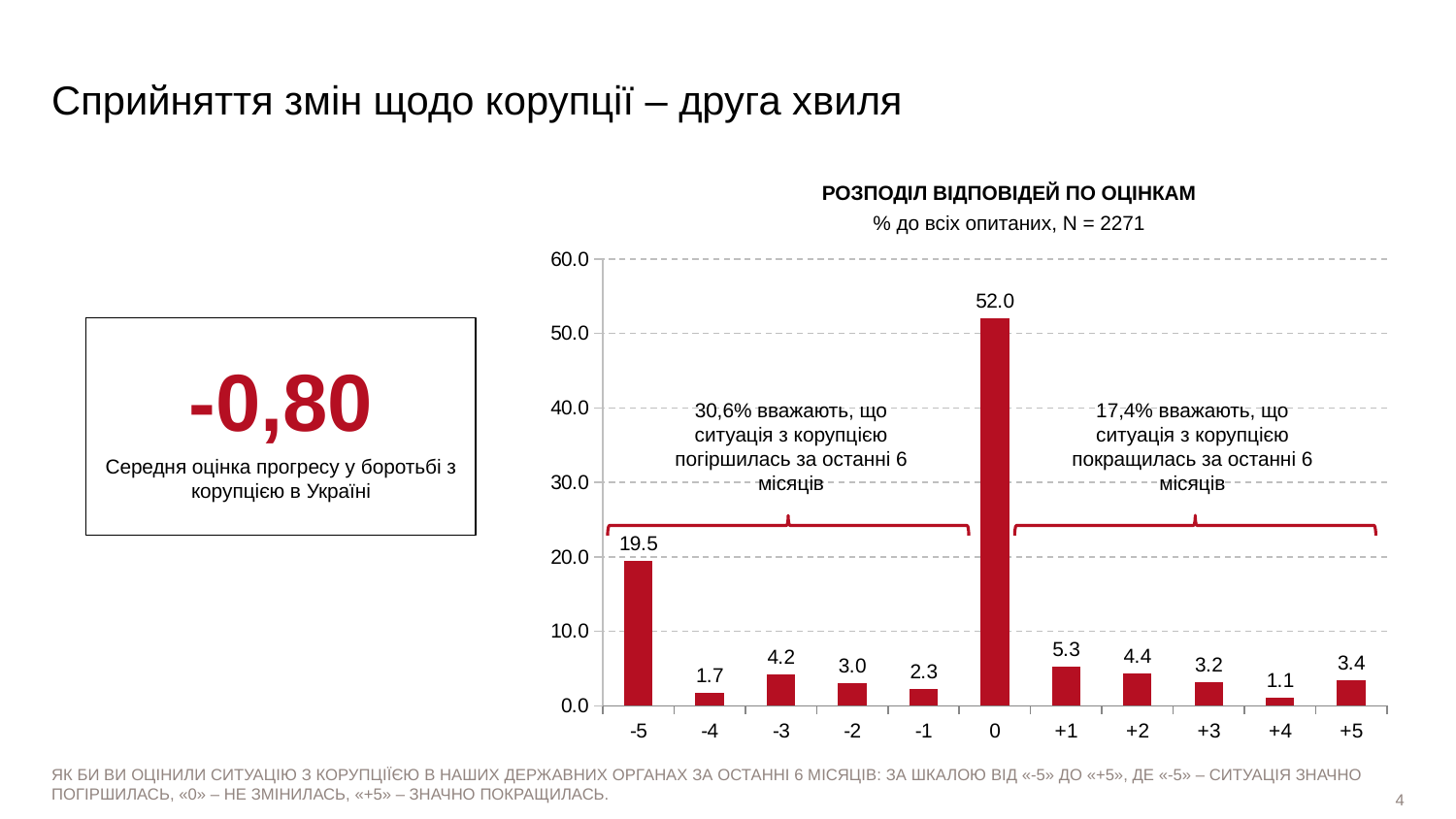
Is the value for "-5" greater or less than 10.0? greater What is the sample size N stated in the chart subtitle? 2271 What is the value for the "0" category? 52.0 Which category has the highest value? 0 How many categories are shown on the x axis? 11 Which is larger, the value for "+1" or the value for "-3"? +1 What is the title of the chart? РОЗПОДІЛ ВІДПОВІДЕЙ ПО ОЦІНКАМ What is the value for the "-5" category? 19.5 What kind of chart is shown on the slide? Bar chart What is the difference between the values for "0" and "-5"? 32.5 Which category has the lowest value? +4 What is the value for the "+4" category? 1.1